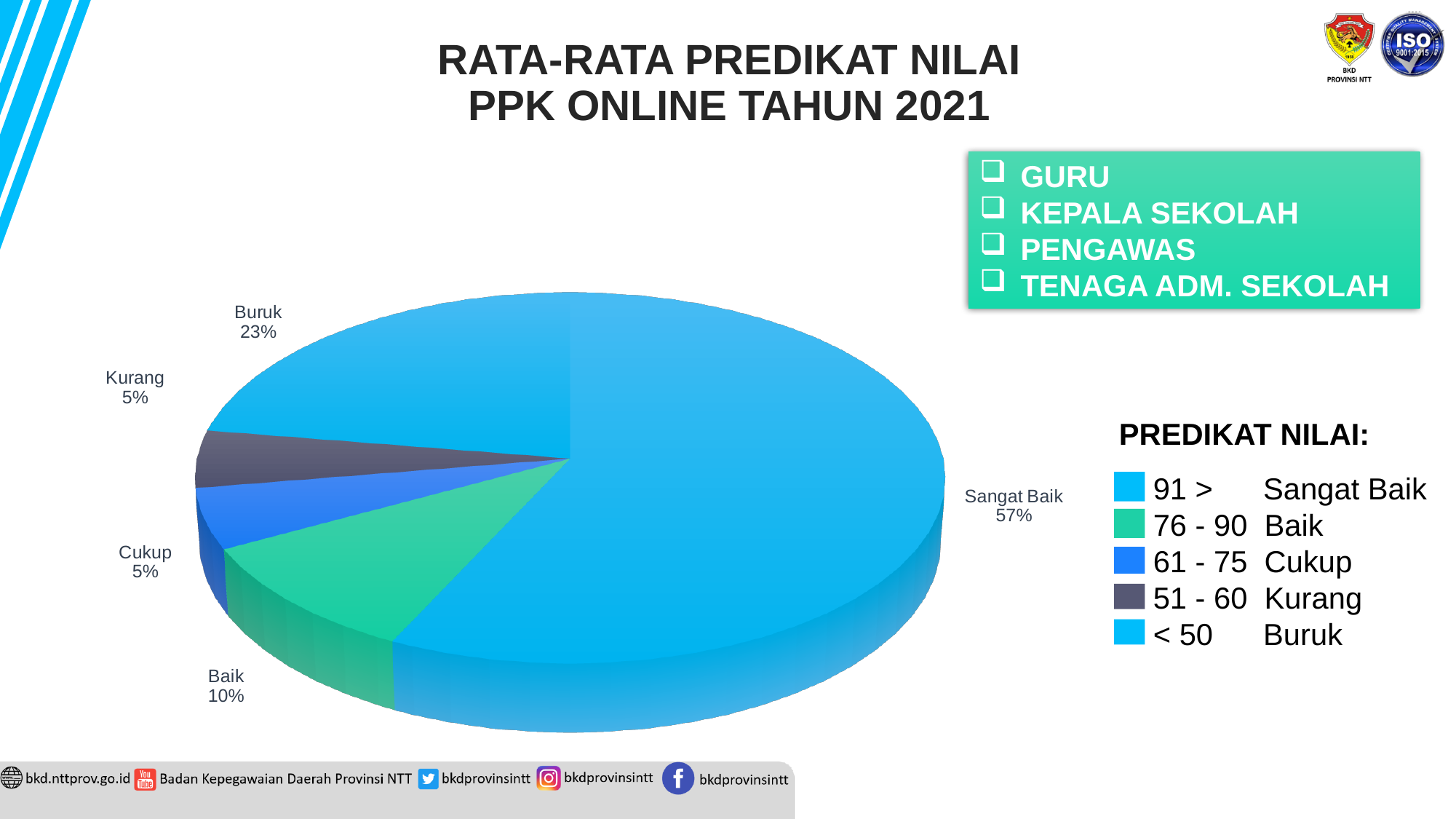
Which is larger, the Buruk slice or the Baik slice? Buruk How many entries does the PREDIKAT NILAI legend list? 5 Which category has the largest slice of the pie? Sangat Baik How many slices does the pie chart have? 5 What share of the pie does Buruk have? 23% What share of the pie does Baik have? 10% What is the difference in percentage points between Sangat Baik and Buruk? 34 What share of the pie does Sangat Baik have? 57% What is the combined share of Cukup and Kurang? 10% What kind of chart is shown on the slide? pie chart What share of the pie does Kurang have? 5% According to the legend, which score range corresponds to Baik? 76 - 90